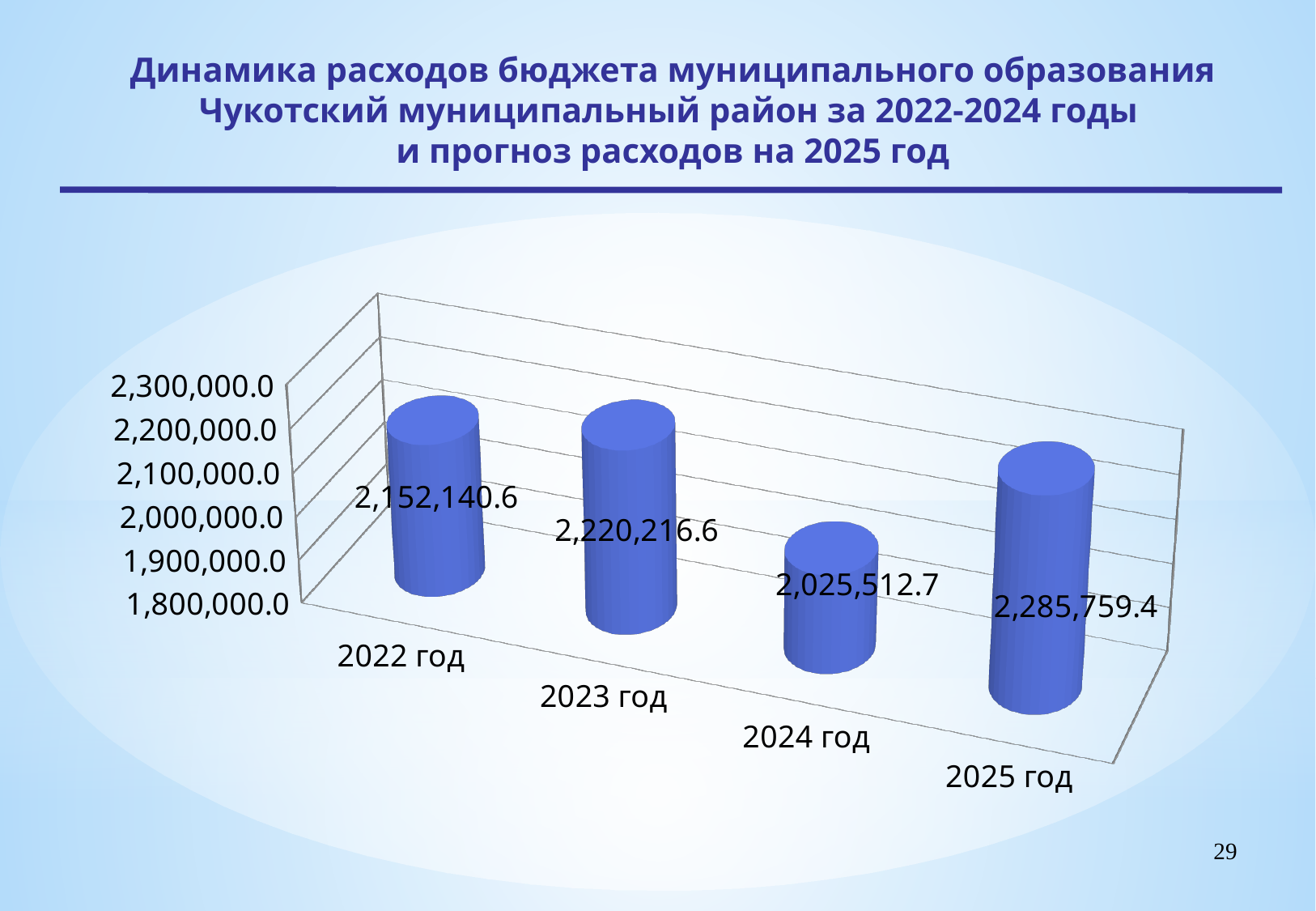
Which year has the lowest value on the chart? 2024 год Which year has the highest value on the chart? 2025 год What kind of chart is shown on the slide? bar chart Which is larger, the value for 2023 год or the value for 2022 год? 2023 год What is the value shown for 2022 год? 2,152,140.6 What is the value shown for 2025 год? 2,285,759.4 How many years (categories) are shown on the chart? 4 Does the value rise or fall from 2023 год to 2024 год? fall What is the value shown for 2024 год? 2,025,512.7 What is the difference between the values for 2023 год and 2022 год? 68,076.0 Is the value for 2024 год greater or less than 2,100,000.0? less What is the difference between the values for 2025 год and 2024 год? 260,246.7